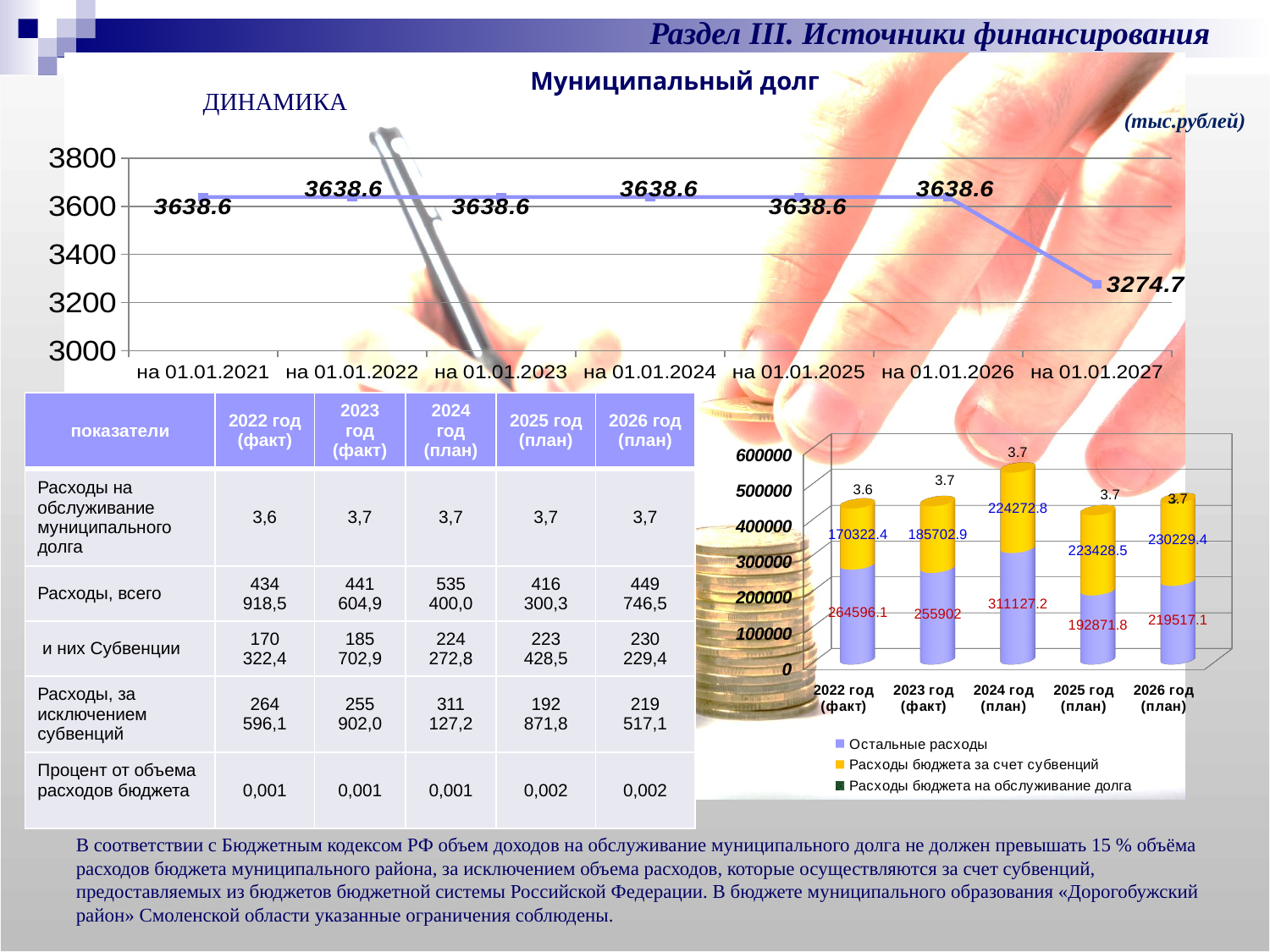
In the line chart 'Муниципальный долг', how many data points are plotted? 7 In the stacked bar chart at the bottom right, which year has the lowest value of Остальные расходы? 2025 год (план) In the line chart 'Муниципальный долг', which date has the lowest value? на 01.01.2027 What kind of chart is the chart at the bottom right of the slide? stacked bar chart In the line chart 'Муниципальный долг', do the values rise, fall or stay flat from на 01.01.2021 to на 01.01.2026? stay flat In the line chart 'Муниципальный долг', what is the value for на 01.01.2027? 3274.7 In the stacked bar chart at the bottom right, how many series does the legend list? 3 In the stacked bar chart at the bottom right, what is the difference between Остальные расходы for 2024 год (план) and for 2025 год (план)? 118255.4 In the stacked bar chart at the bottom right, what is the value of Расходы бюджета за счет субвенций for 2026 год (план)? 230229.4 In the stacked bar chart at the bottom right, what is the value of Остальные расходы for 2024 год (план)? 311127.2 In the line chart 'Муниципальный долг', what is the value for на 01.01.2024? 3638.6 In the line chart 'Муниципальный долг', what is the difference between the value for на 01.01.2026 and the value for на 01.01.2027? 363.9